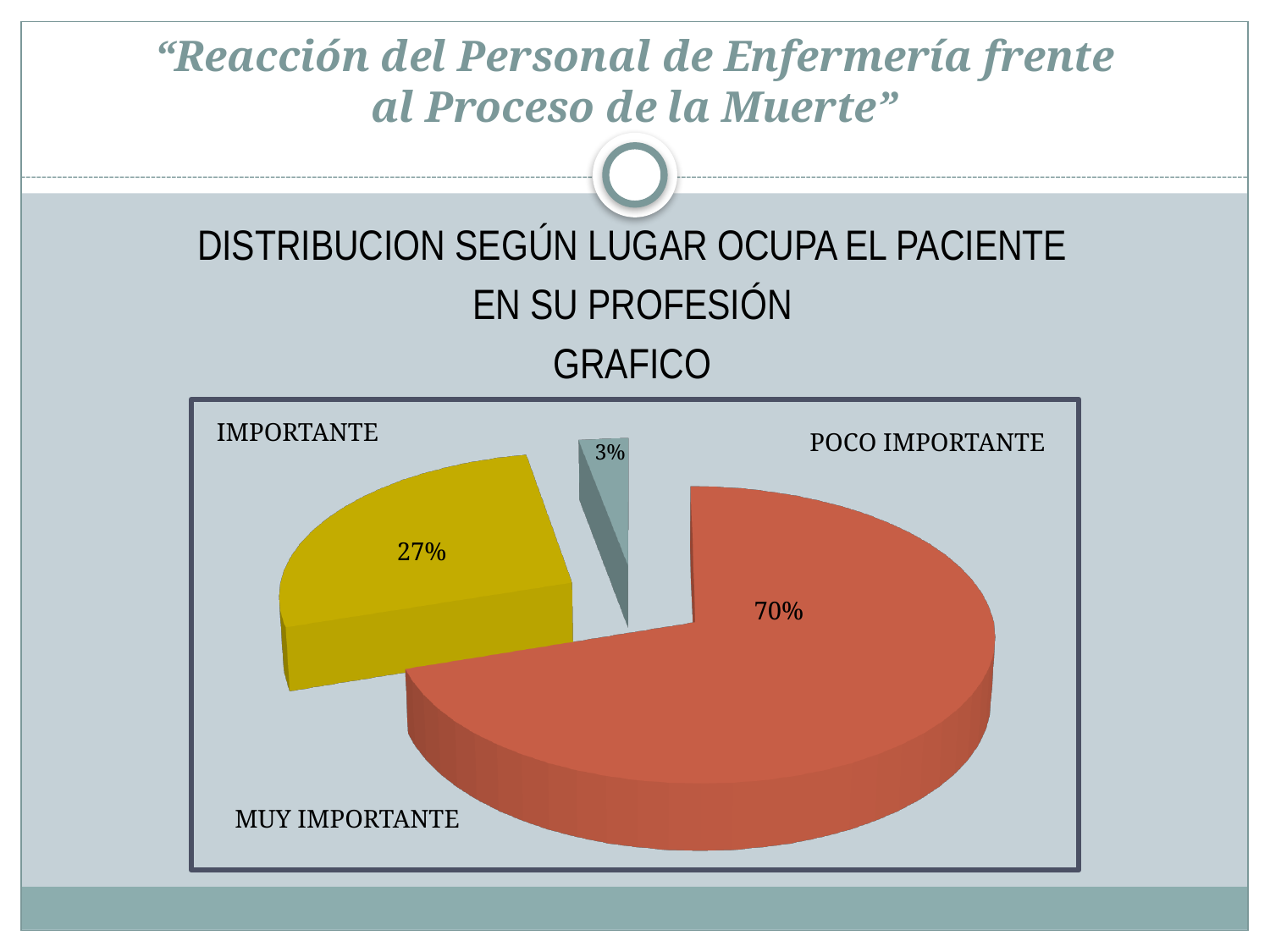
What percentage is shown for POCO IMPORTANTE? 3% How many slices does the pie chart have? 3 Which is larger, the share for IMPORTANTE or the share for POCO IMPORTANTE? IMPORTANTE What colour is the IMPORTANTE slice? Yellow What is the difference in percentage points between MUY IMPORTANTE and IMPORTANTE? 43 What percentage is shown for IMPORTANTE? 27% Which category has the smallest share of the pie? POCO IMPORTANTE What colour is the MUY IMPORTANTE slice? Red What percentage is shown for MUY IMPORTANTE? 70% What kind of chart is shown on the slide? Pie chart What is the difference in percentage points between IMPORTANTE and POCO IMPORTANTE? 24 Which category has the largest share of the pie? MUY IMPORTANTE